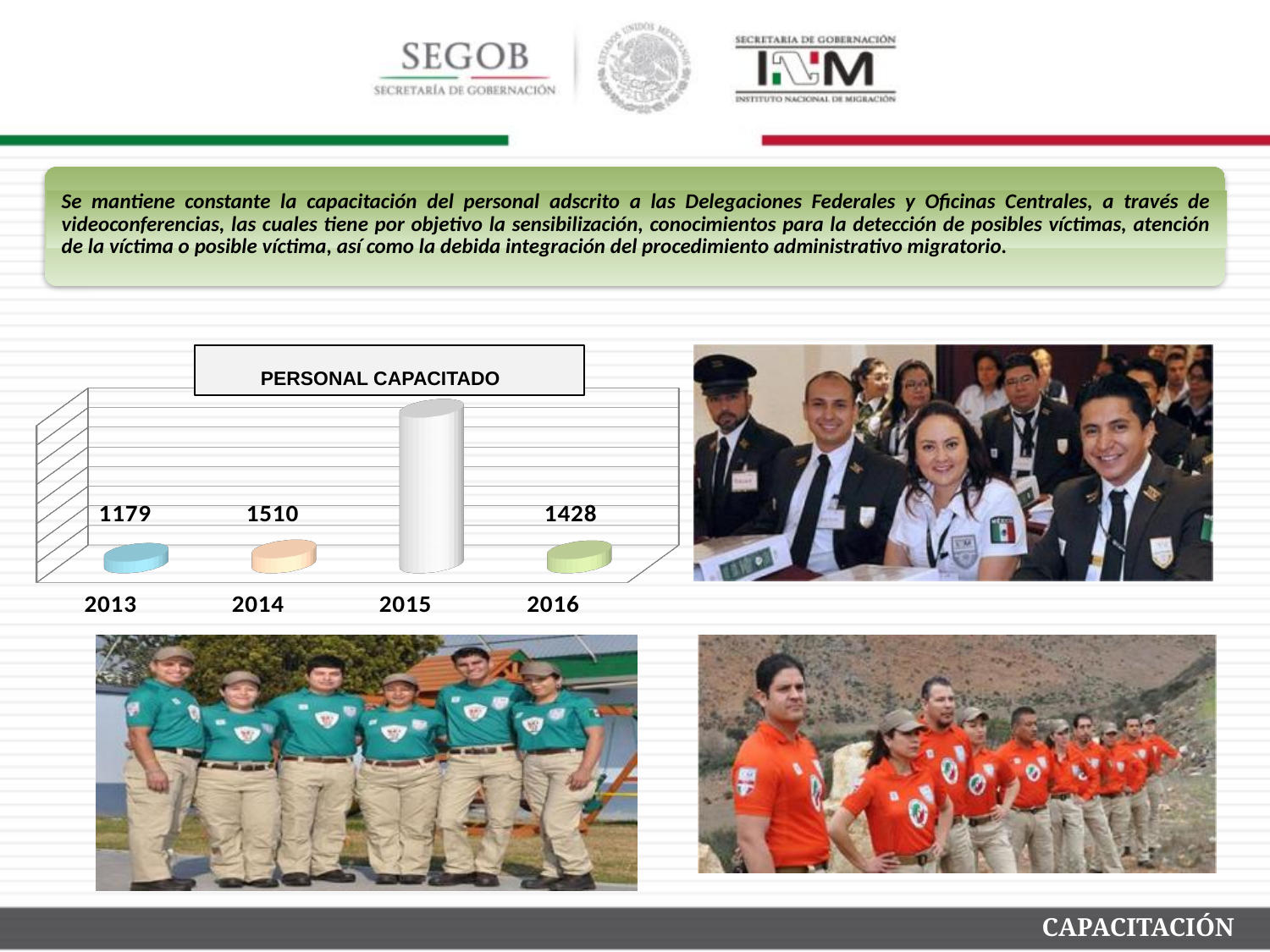
How many years are shown on the x axis of the PERSONAL CAPACITADO chart? 4 In the PERSONAL CAPACITADO chart, what is the value for 2016? 1428 In the PERSONAL CAPACITADO chart, what is the value for 2013? 1179 In the PERSONAL CAPACITADO chart, which year has the tallest bar? 2015 What is the title of the chart on the slide? PERSONAL CAPACITADO In the PERSONAL CAPACITADO chart, which year has the lowest value? 2013 In the PERSONAL CAPACITADO chart, which is larger, the value for 2013 or the value for 2016? 2016 What kind of chart is the PERSONAL CAPACITADO chart? Bar chart In the PERSONAL CAPACITADO chart, what is the difference between the values for 2016 and 2013? 249 In the PERSONAL CAPACITADO chart, what is the difference between the values for 2014 and 2016? 82 In the PERSONAL CAPACITADO chart, what is the difference between the values for 2014 and 2013? 331 In the PERSONAL CAPACITADO chart, what is the value for 2014? 1510